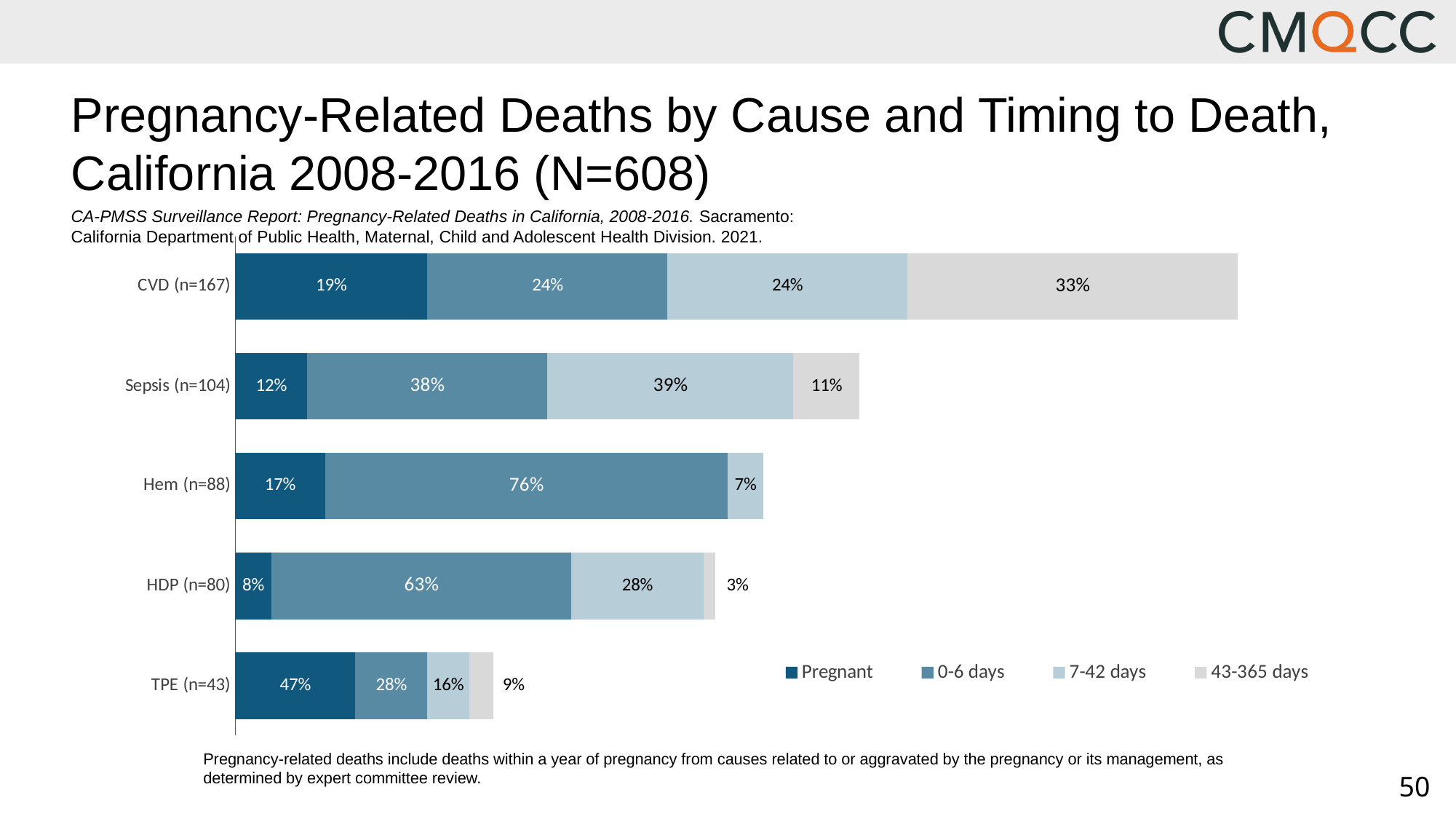
What kind of chart is shown on the slide? Stacked bar chart Which cause has the lowest Pregnant percentage? HDP (n=80) Which legend entry is shown in the darkest blue colour? Pregnant Which cause has the highest Pregnant percentage? TPE (n=43) What is the difference between the 0-6 days values for Hem (n=88) and HDP (n=80)? 13% What is the 7-42 days value for Sepsis (n=104)? 39% Which is larger, the 43-365 days value for Sepsis (n=104) or for TPE (n=43)? Sepsis (n=104) How many cause categories are plotted on the chart? 5 What is the 0-6 days value for Hem (n=88)? 76% What is the 43-365 days value for CVD (n=167)? 33% How many series does the legend list? 4 What is the Pregnant value for TPE (n=43)? 47%